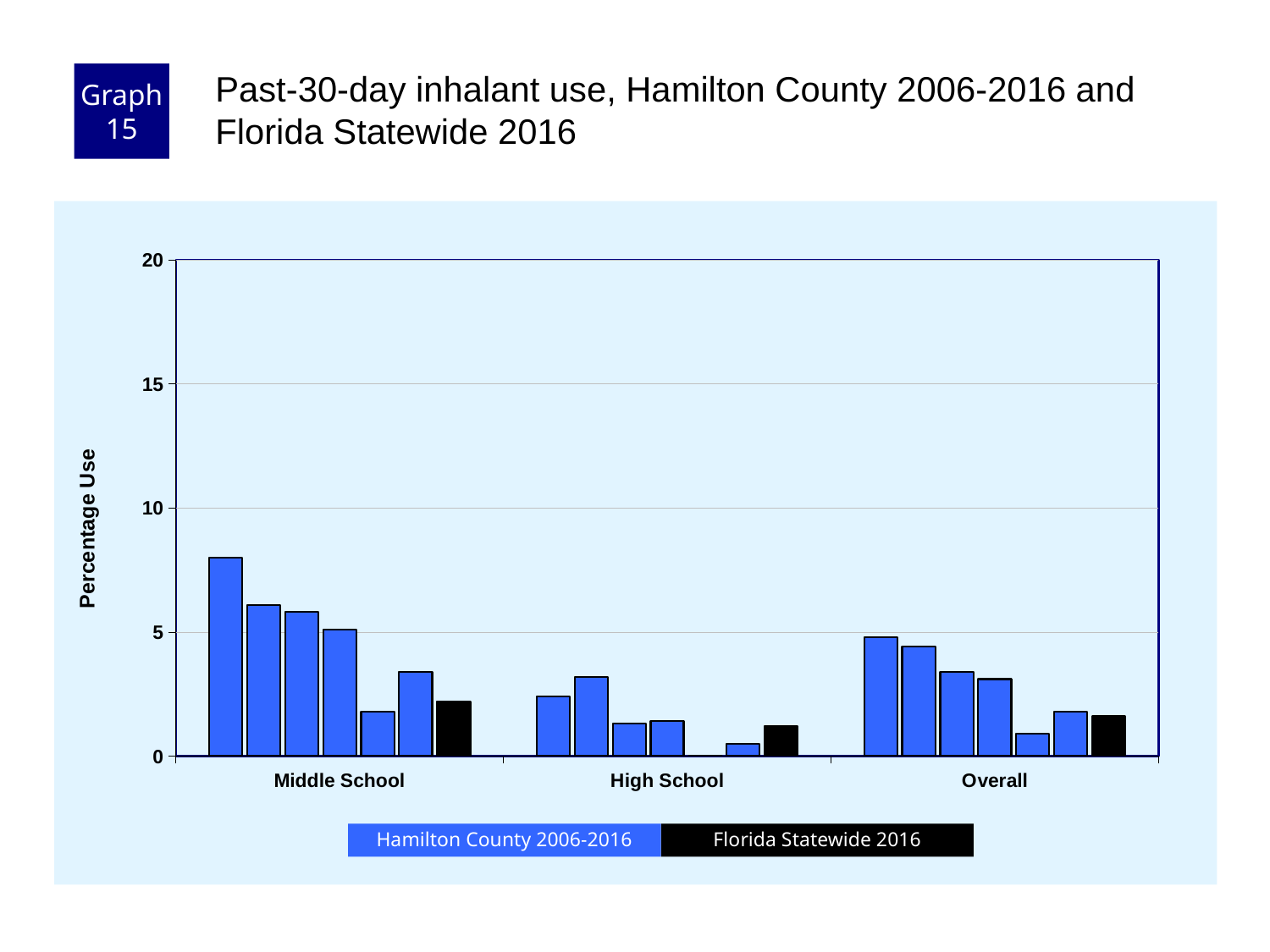
What is the label of the y axis? Percentage Use Which category group contains the tallest bar on the chart? Middle School Which category group has the lowest Florida Statewide 2016 bar? High School What colour are the Florida Statewide 2016 bars? black Is the value of the tallest Hamilton County bar in the High School group greater or less than 5? less Do the Hamilton County 2006-2016 bars in the Overall group generally rise or fall from left to right? fall Which is larger, the Florida Statewide 2016 bar for Middle School or the Florida Statewide 2016 bar for High School? Middle School How many category groups are shown on the x axis? 3 Is the value of the tallest Hamilton County bar in the Middle School group greater or less than 5? greater How many series does the legend list? 2 Is the value of the Florida Statewide 2016 bar for High School greater or less than 5? less What kind of chart is shown on the slide? bar chart